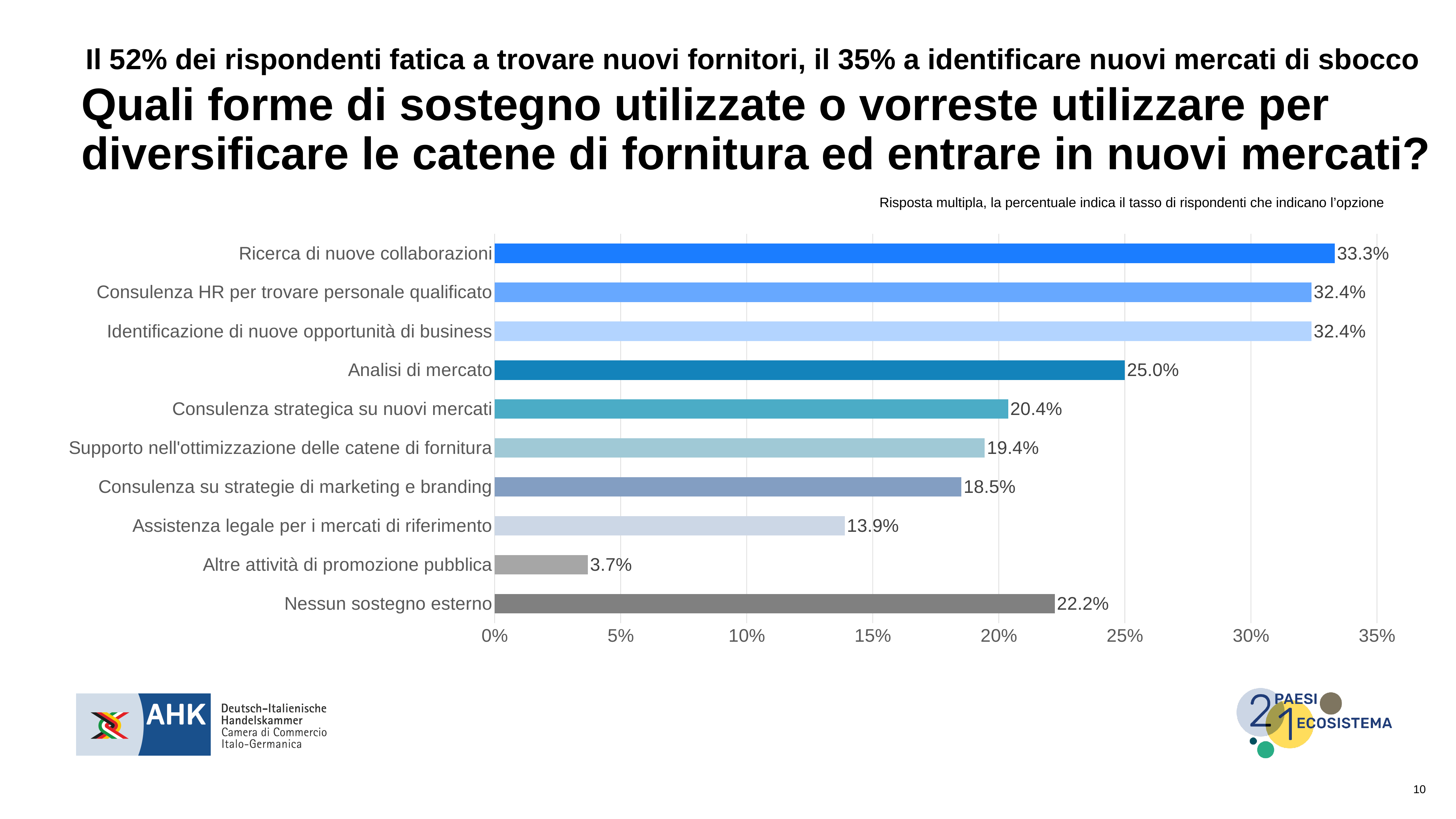
What is the difference between "Analisi di mercato" and "Consulenza strategica su nuovi mercati"? 4.6% Which is larger: "Supporto nell'ottimizzazione delle catene di fornitura" or "Consulenza su strategie di marketing e branding"? Supporto nell'ottimizzazione delle catene di fornitura How many categories are shown in the chart? 10 What kind of chart is shown on the slide? Bar chart What is the difference between "Nessun sostegno esterno" and "Altre attività di promozione pubblica"? 18.5% Is the value for "Consulenza HR per trovare personale qualificato" greater or less than 30%? greater What is the value for "Nessun sostegno esterno"? 22.2% What is the value for "Ricerca di nuove collaborazioni"? 33.3% Which category has the highest value? Ricerca di nuove collaborazioni Which category has the lowest value? Altre attività di promozione pubblica What is the value for "Analisi di mercato"? 25.0% What is the value for "Assistenza legale per i mercati di riferimento"? 13.9%